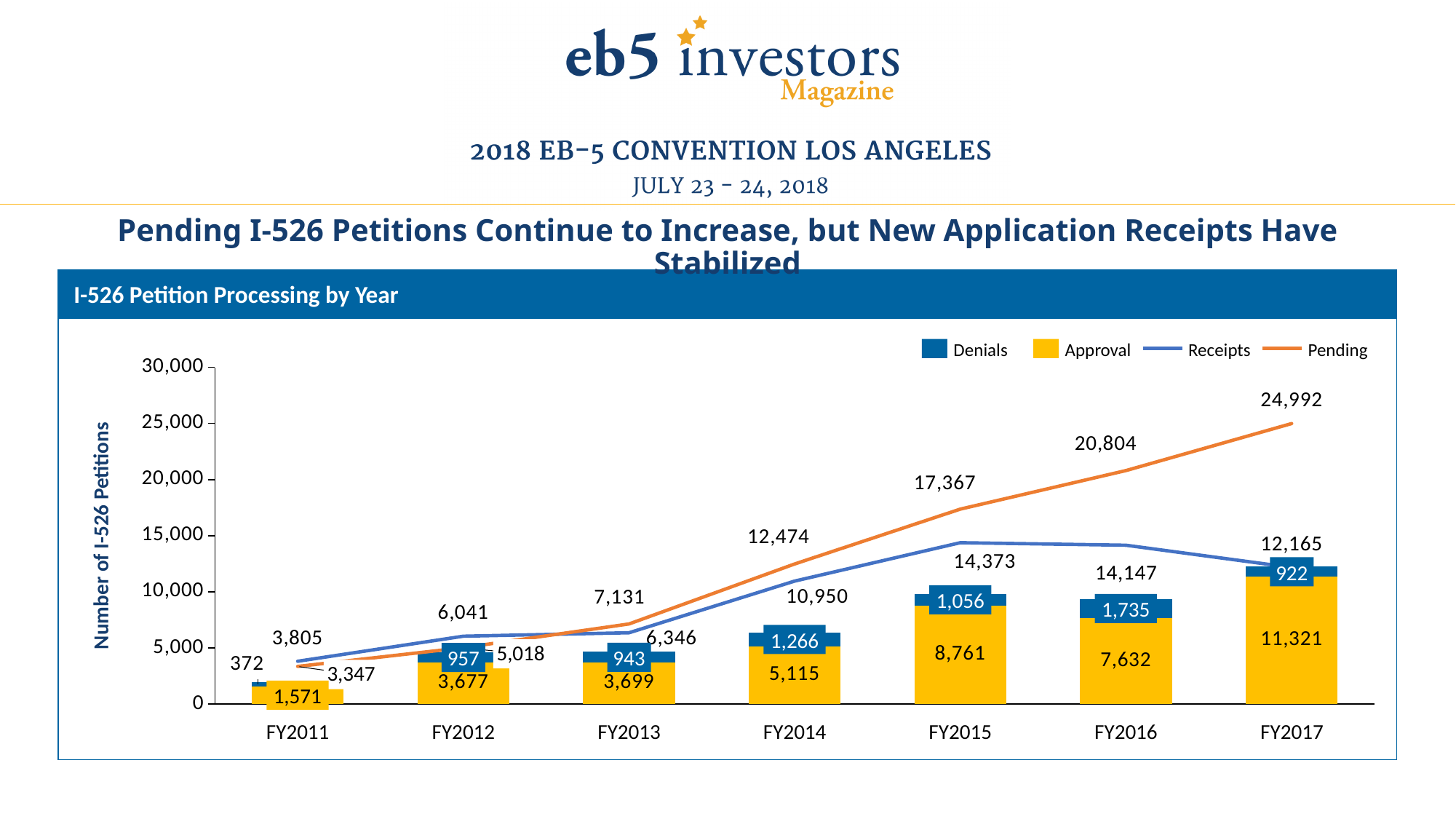
By how much did the Pending value increase from FY2016 to FY2017? 4,188 What is the Approval value for FY2017? 11,321 Does the Pending line rise or fall from FY2011 to FY2017? rises Which year has the larger Receipts value, FY2015 or FY2016? FY2015 In which fiscal year is the Denials value highest? FY2016 How many series does the legend list? 4 In which fiscal year is the Approval value lowest? FY2011 What is the Receipts value for FY2013? 6,346 What is the Denials value for FY2014? 1,266 What is the Pending value for FY2016? 20,804 How many fiscal years are shown on the x axis? 7 What is the total of the stacked bar (Denials plus Approval) for FY2015? 9,817